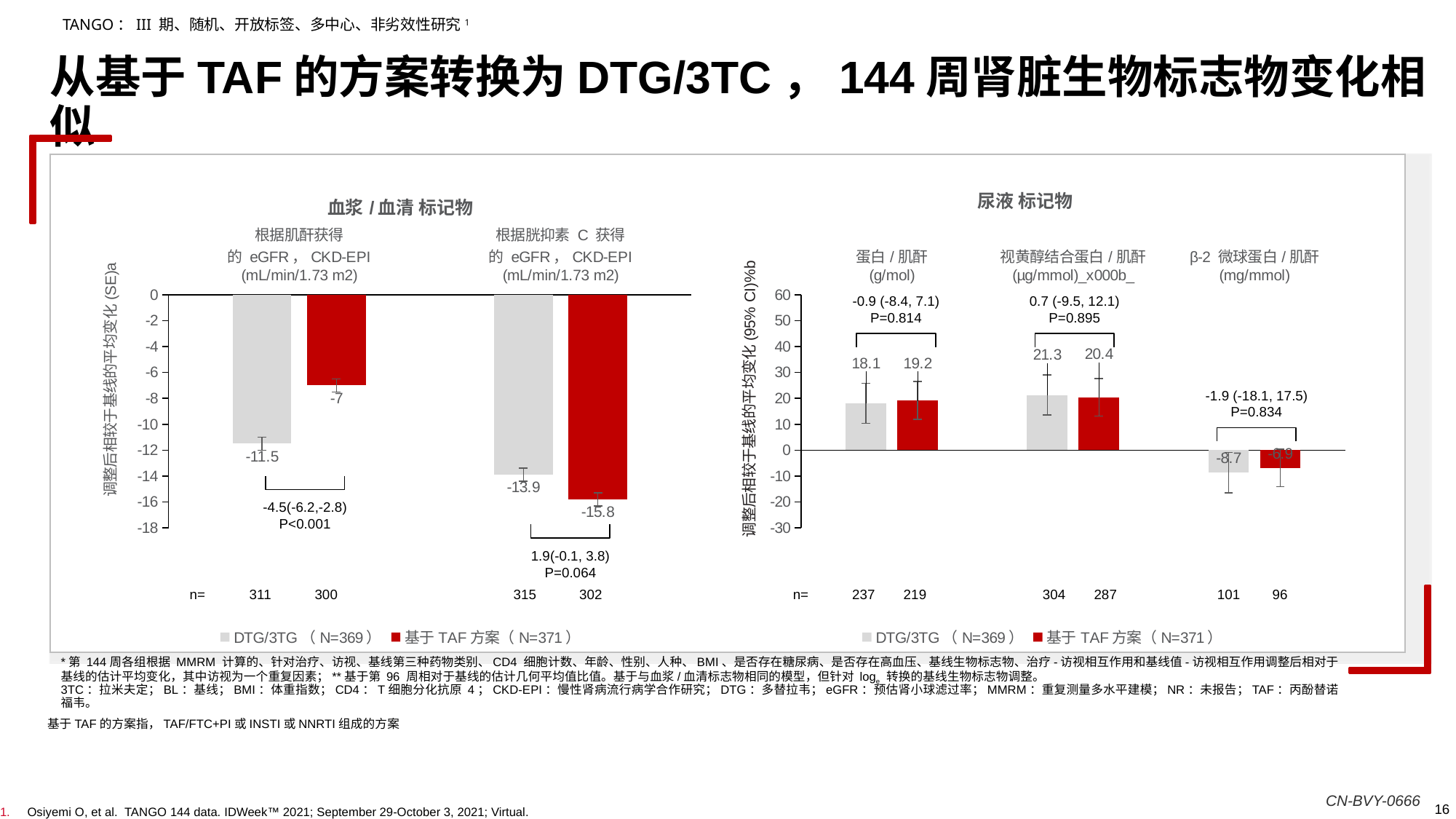
In the 血浆 / 血清 标记物 chart on the left, which group has the lower (more negative) value for cystatin C-based eGFR? 基于 TAF 方案 In the 血浆 / 血清 标记物 chart on the left, what is the value for the 基于 TAF 方案 group for eGFR based on creatinine (CKD-EPI)? -7 What kind of chart is the 血浆 / 血清 标记物 chart on the left? bar chart In the 尿液 标记物 chart on the right, which bar is the highest? DTG/3TG for 视黄醇结合蛋白 / 肌酐 (21.3) In the 尿液 标记物 chart on the right, is the DTG/3TG value for β-2 微球蛋白 / 肌酐 greater or less than 0? less In the 血浆 / 血清 标记物 chart on the left, what is the value for DTG/3TG for eGFR based on creatinine (CKD-EPI)? -11.5 How many series does the legend of the 尿液 标记物 chart list? 2 In the 尿液 标记物 chart on the right, what is the value for DTG/3TG for 蛋白 / 肌酐 (g/mol)? 18.1 In the 尿液 标记物 chart on the right, what is the n for the 基于 TAF 方案 group for β-2 微球蛋白 / 肌酐? 96 In the 尿液 标记物 chart on the right, what is the value for the 基于 TAF 方案 group for 视黄醇结合蛋白 / 肌酐? 20.4 In the 血浆 / 血清 标记物 chart on the left, what is the difference between the DTG/3TG value (-11.5) and the 基于 TAF 方案 value (-7) for creatinine-based eGFR? -4.5 In the 血浆 / 血清 标记物 chart on the left, what is the value for the 基于 TAF 方案 group for eGFR based on cystatin C? -15.8